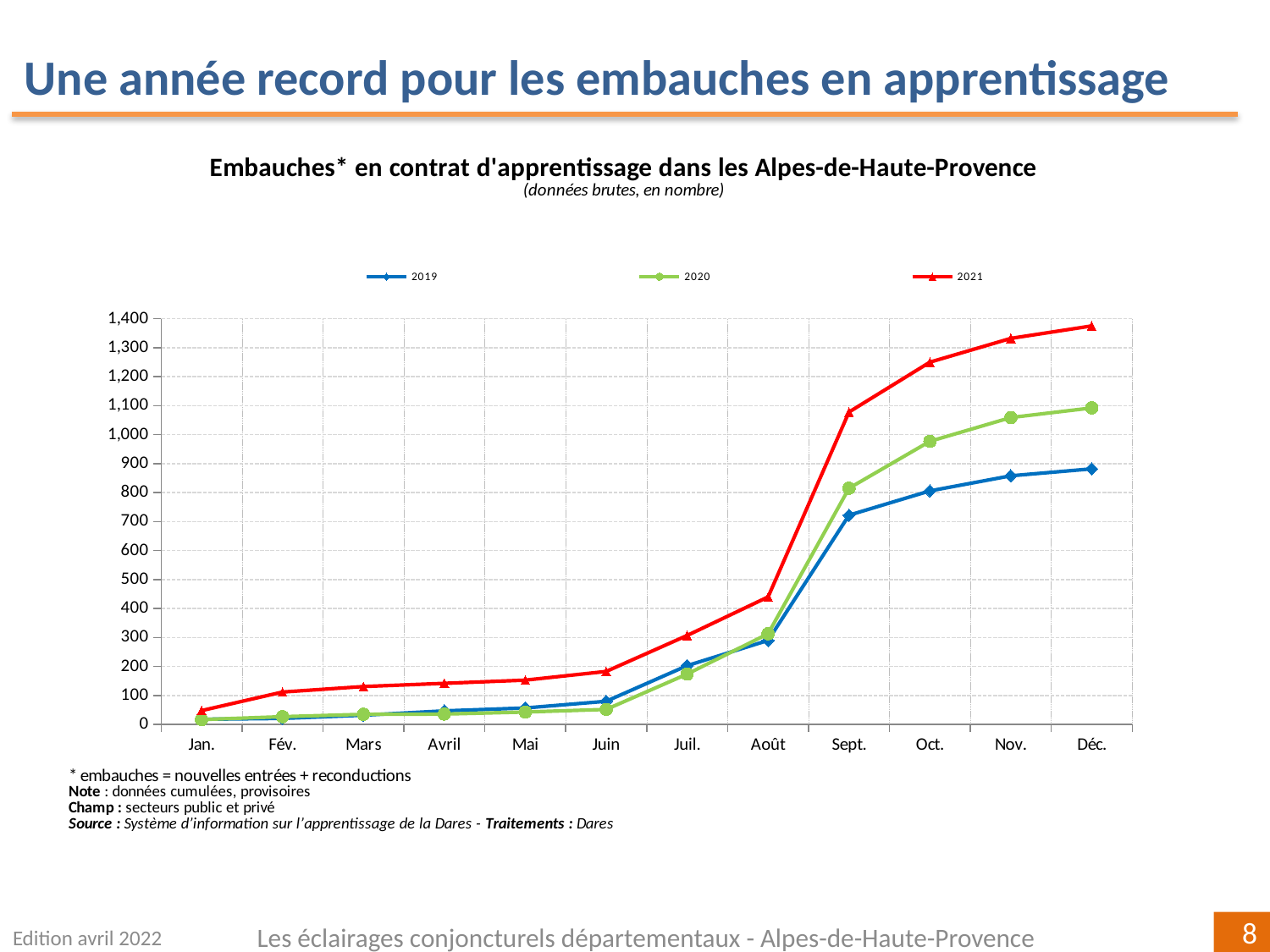
Is the value for 2019 in Déc. greater or less than 900? less What kind of chart is shown on the slide? line chart How many series does the legend list? 3 How many months are plotted along the x axis? 12 Is the value for 2021 in Déc. greater or less than 1,300? greater Which series has the lowest value in Déc.? 2019 Do the values for the 2021 series rise or fall from Jan. to Déc.? rise Is the value for 2020 in Oct. greater or less than 1,000? less Which series has the highest value in Déc.? 2021 What is the title of the chart? Embauches* en contrat d'apprentissage dans les Alpes-de-Haute-Provence Which is larger in Mars, the value for 2021 or the value for 2020? 2021